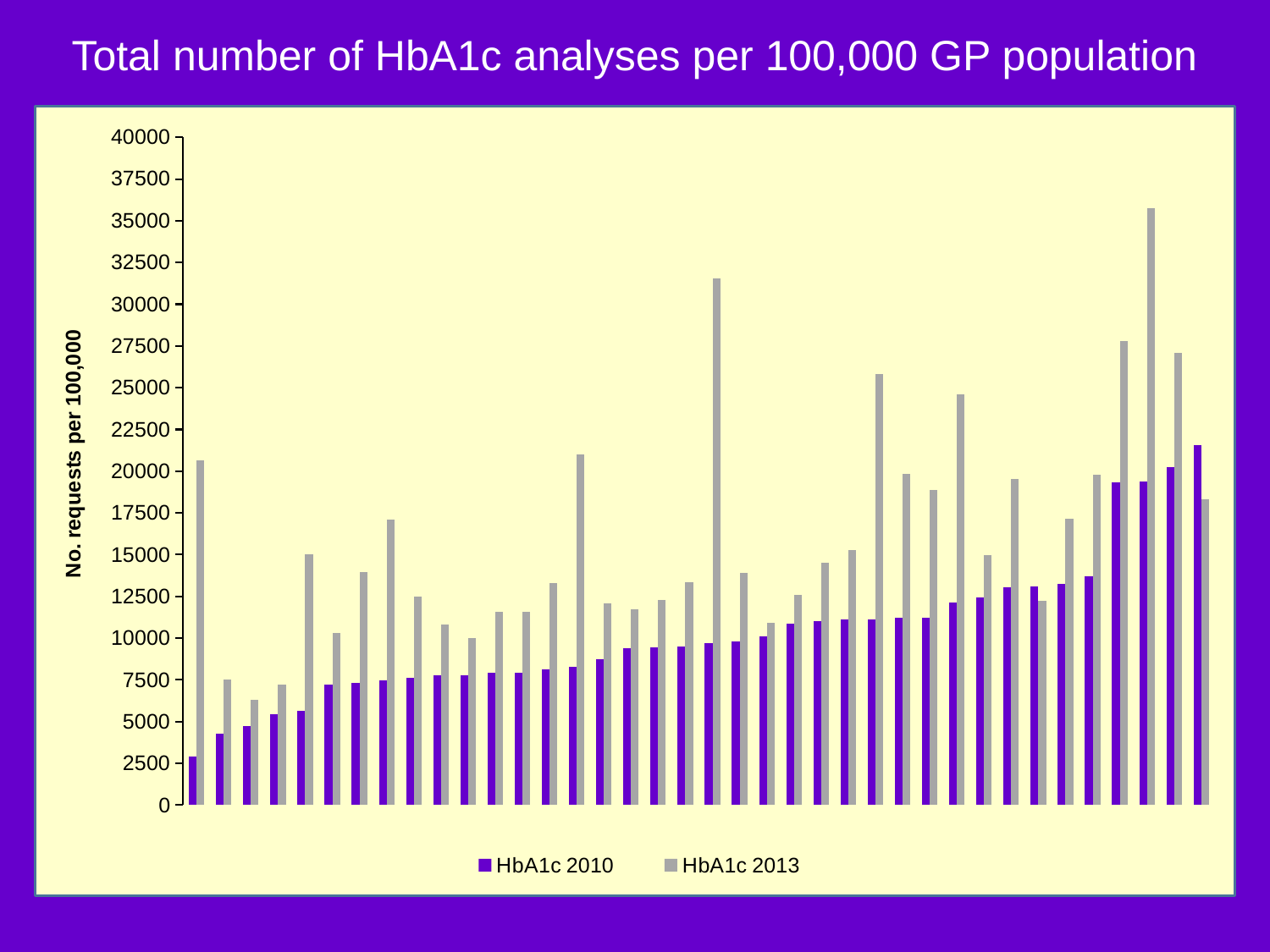
For the rightmost category, which series has the larger value, HbA1c 2010 or HbA1c 2013? HbA1c 2010 What is the label on the vertical axis? No. requests per 100,000 What kind of chart is shown on the slide? bar chart Is the leftmost HbA1c 2010 bar greater or less than 5000? less Is the tallest HbA1c 2013 bar greater or less than 35000? greater Which series contains the tallest bar on the chart? HbA1c 2013 Is the tallest HbA1c 2010 bar greater or less than 20000? greater For the leftmost category, which series has the larger value, HbA1c 2010 or HbA1c 2013? HbA1c 2013 Do the HbA1c 2010 values rise or fall from left to right along the x axis? rise What are the two series named in the legend? HbA1c 2010 and HbA1c 2013 How many series does the legend list? 2